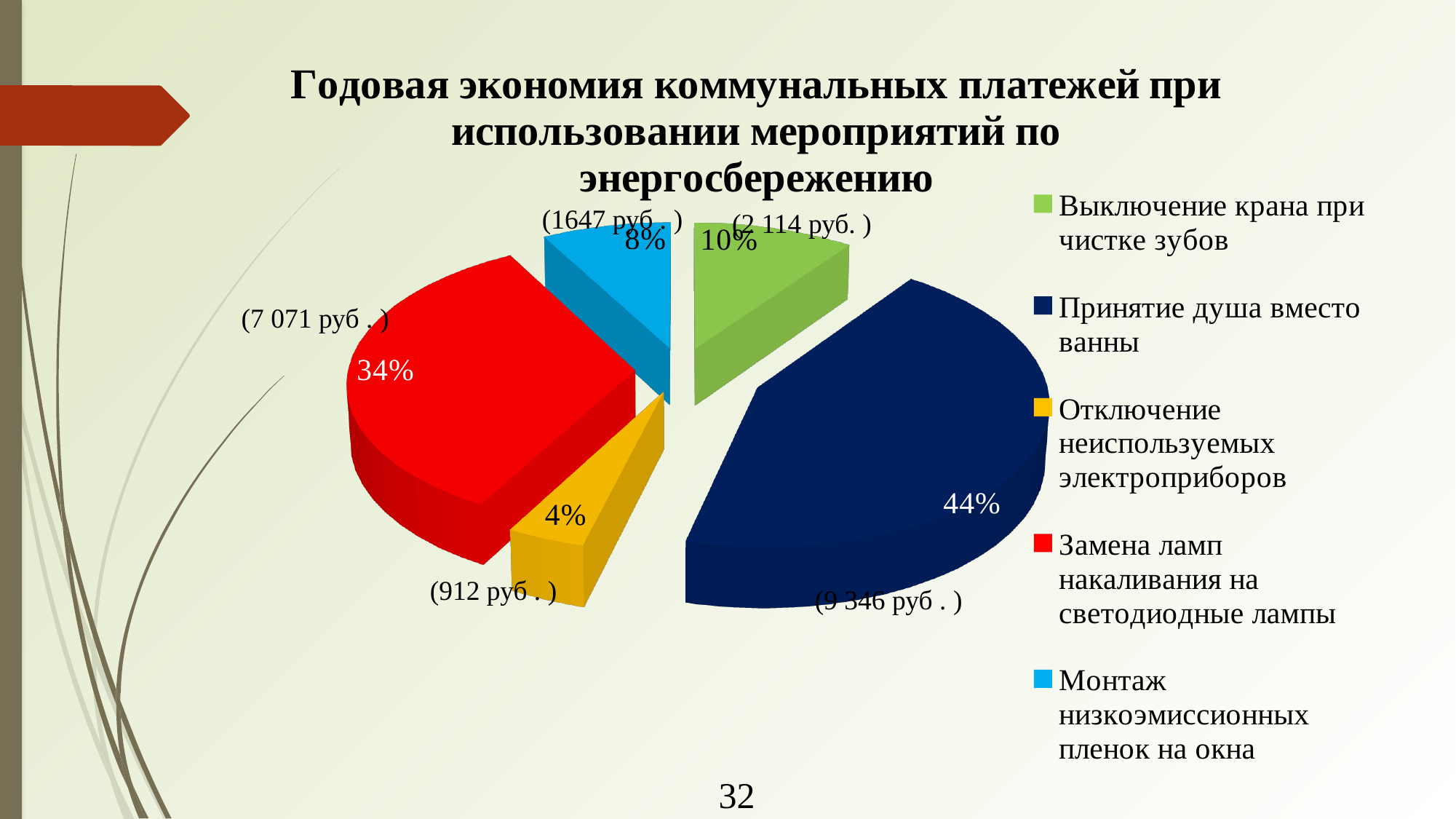
Which saves more per year: "Замена ламп накаливания на светодиодные лампы" or "Выключение крана при чистке зубов"? Замена ламп накаливания на светодиодные лампы By how many percentage points does the share of "Принятие душа вместо ванны" exceed that of "Замена ламп накаливания на светодиодные лампы"? 10% What kind of chart is shown on the slide? Pie chart What share of the pie does "Отключение неиспользуемых электроприборов" represent? 4% What share of the pie does "Принятие душа вместо ванны" represent? 44% What annual saving in rubles is shown for "Принятие душа вместо ванны"? 9 346 руб. Which measure gives the largest annual saving? Принятие душа вместо ванны What share of the pie does "Замена ламп накаливания на светодиодные лампы" represent? 34% What annual saving in rubles is shown for "Монтаж низкоэмиссионных пленок на окна"? 1647 руб. How many energy-saving measures does the legend list? 5 Which measure gives the smallest annual saving? Отключение неиспользуемых электроприборов What annual saving in rubles is shown for "Выключение крана при чистке зубов"? 2 114 руб.